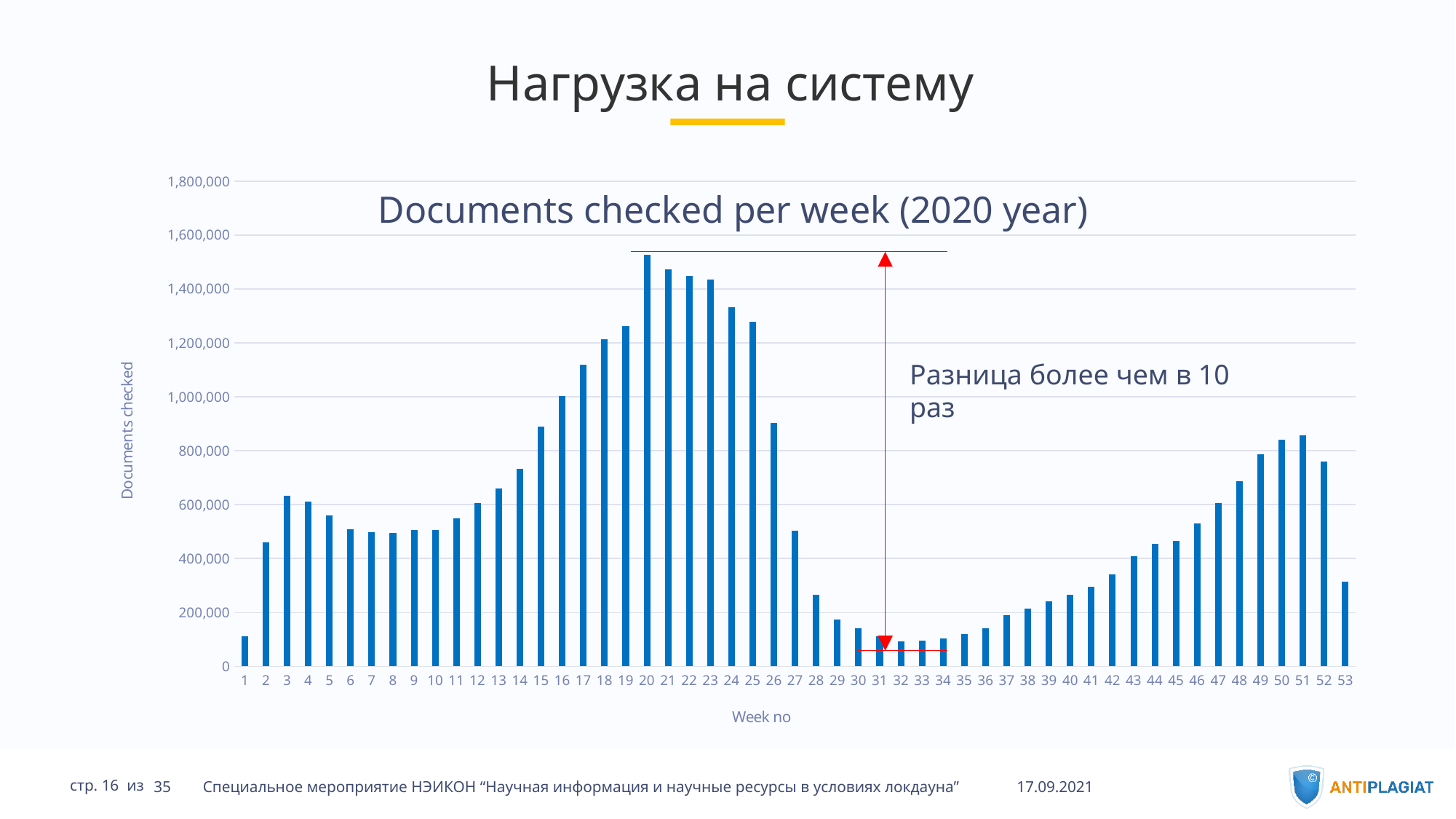
Which week has the highest number of documents checked? Week 20 Is the value for week 31 greater or less than 200,000? less Which week has more documents checked, week 20 or week 31? Week 20 Which week has more documents checked, week 3 or week 8? Week 3 Is the value for week 20 greater or less than 1,400,000? greater What is the title of the chart? Documents checked per week (2020 year) What kind of chart is shown on the slide? Bar chart Is the value for week 17 greater or less than 1,000,000? greater Do the values rise or fall from week 20 to week 31? Fall How many weeks are plotted on the x axis of the chart? 53 What is the label of the x axis of the chart? Week no